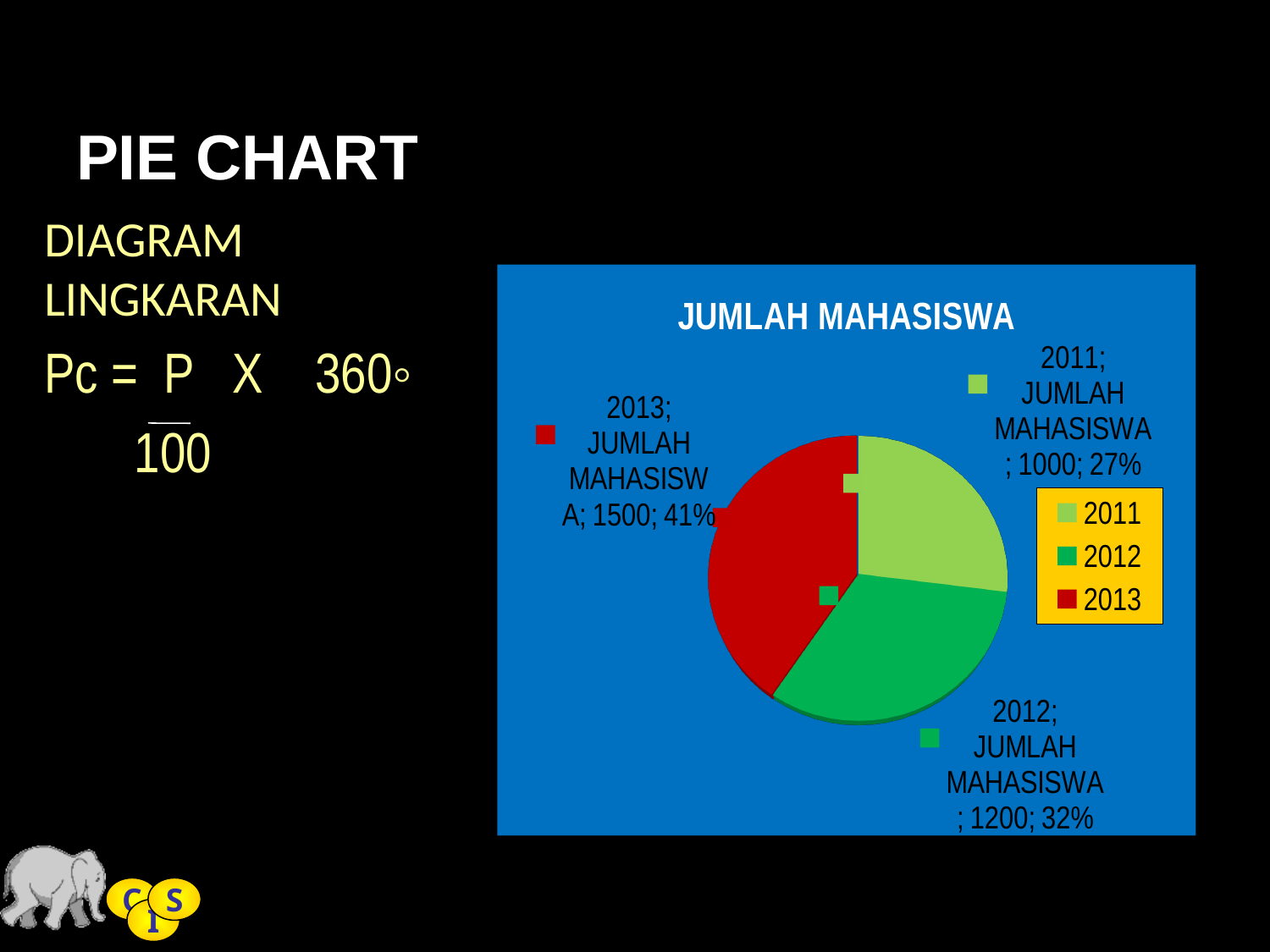
Which is larger in the JUMLAH MAHASISWA pie chart, the value for 2012 or the value for 2011? 2012 What is the difference between the values for 2012 and 2011 in the JUMLAH MAHASISWA pie chart? 200 How many slices does the JUMLAH MAHASISWA pie chart have? 3 What is the value for 2011 in the JUMLAH MAHASISWA pie chart? 1000 What is the value for 2013 in the JUMLAH MAHASISWA pie chart? 1500 What share of the JUMLAH MAHASISWA pie does 2013 represent? 41% What share of the JUMLAH MAHASISWA pie does 2012 represent? 32% Which year has the smallest slice in the JUMLAH MAHASISWA pie chart? 2011 What type of chart is shown on the slide? Pie chart Which year has the largest slice in the JUMLAH MAHASISWA pie chart? 2013 What is the difference between the values for 2013 and 2011 in the JUMLAH MAHASISWA pie chart? 500 What is the value for 2012 in the JUMLAH MAHASISWA pie chart? 1200